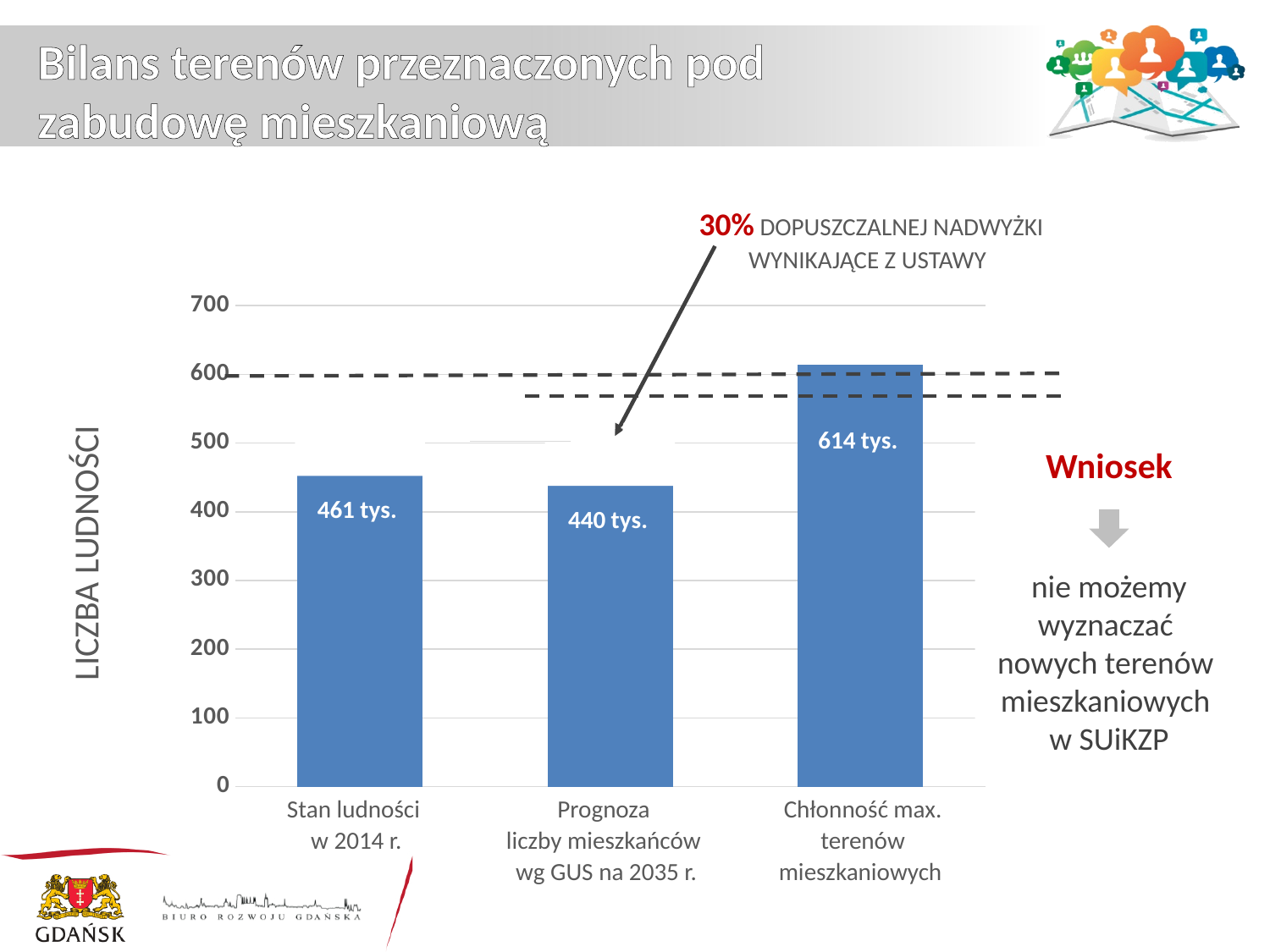
Is the value for "Chłonność max. terenów mieszkaniowych" greater or less than 600? greater Which is larger: "Stan ludności w 2014 r." or "Prognoza liczby mieszkańców wg GUS na 2035 r."? Stan ludności w 2014 r. Which category has the highest value? Chłonność max. terenów mieszkaniowych What is the value for "Chłonność max. terenów mieszkaniowych"? 614 tys. What is the difference between "Chłonność max. terenów mieszkaniowych" and "Stan ludności w 2014 r."? 153 tys. What is the value for "Prognoza liczby mieszkańców wg GUS na 2035 r."? 440 tys. What is the difference between "Stan ludności w 2014 r." and "Prognoza liczby mieszkańców wg GUS na 2035 r."? 21 tys. What is the label of the vertical axis? LICZBA LUDNOŚCI Which category has the lowest value? Prognoza liczby mieszkańców wg GUS na 2035 r. What kind of chart is shown on the slide? bar chart How many bars are shown in the chart? 3 What is the value for "Stan ludności w 2014 r."? 461 tys.